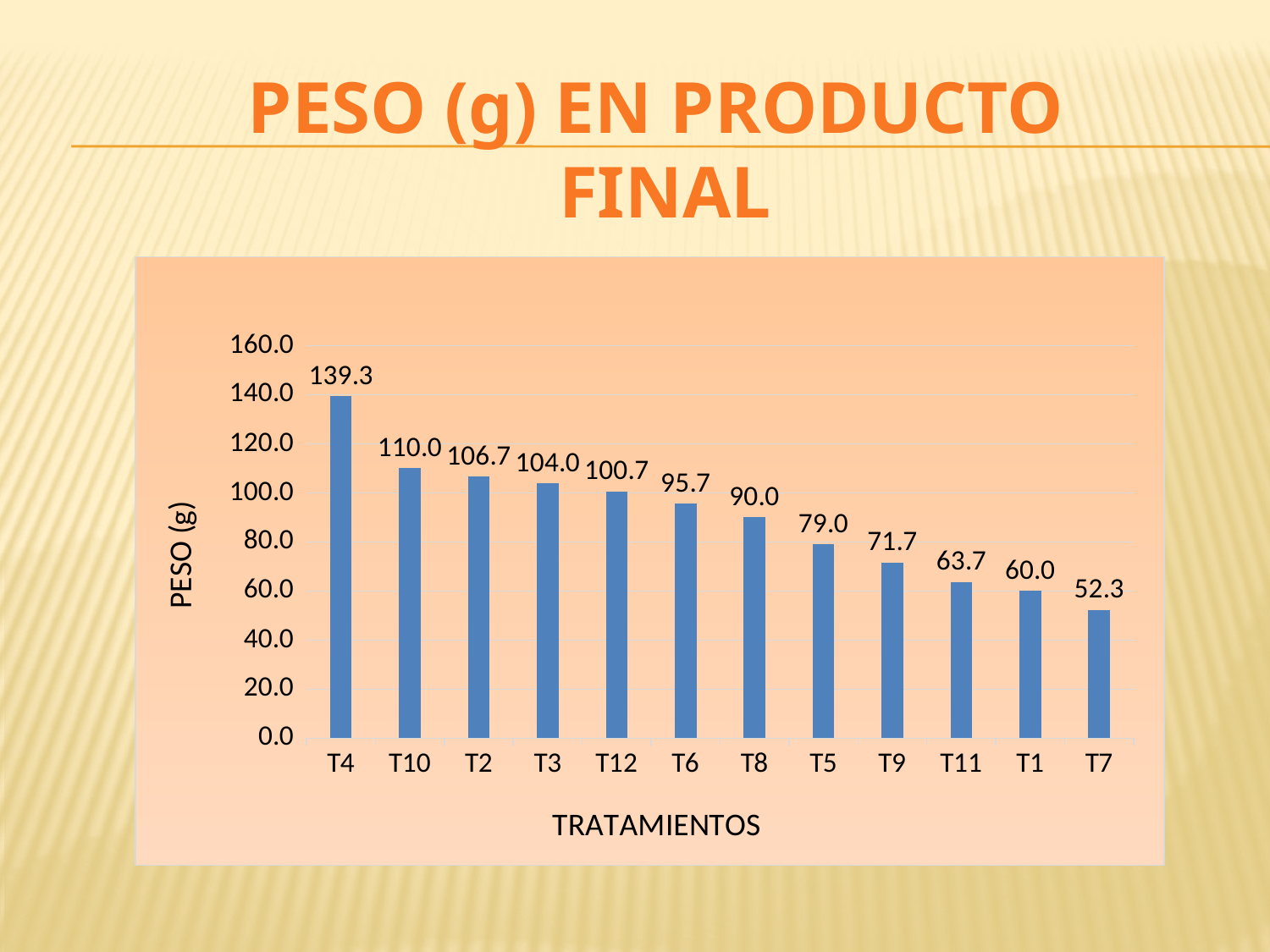
Which is larger, the value for T6 or the value for T9? T6 What is the difference between the values for T4 and T10? 29.3 What is the value for T4? 139.3 What kind of chart is shown? bar chart What is the value for T8? 90.0 Do the values rise or fall from left to right along the x axis? fall What is the difference between the values for T5 and T7? 26.7 Which treatment has the highest weight? T4 How many treatments are shown on the x axis? 12 Which treatment has the lowest weight? T7 Is the value for T12 greater or less than 80.0? greater What is the value for T11? 63.7